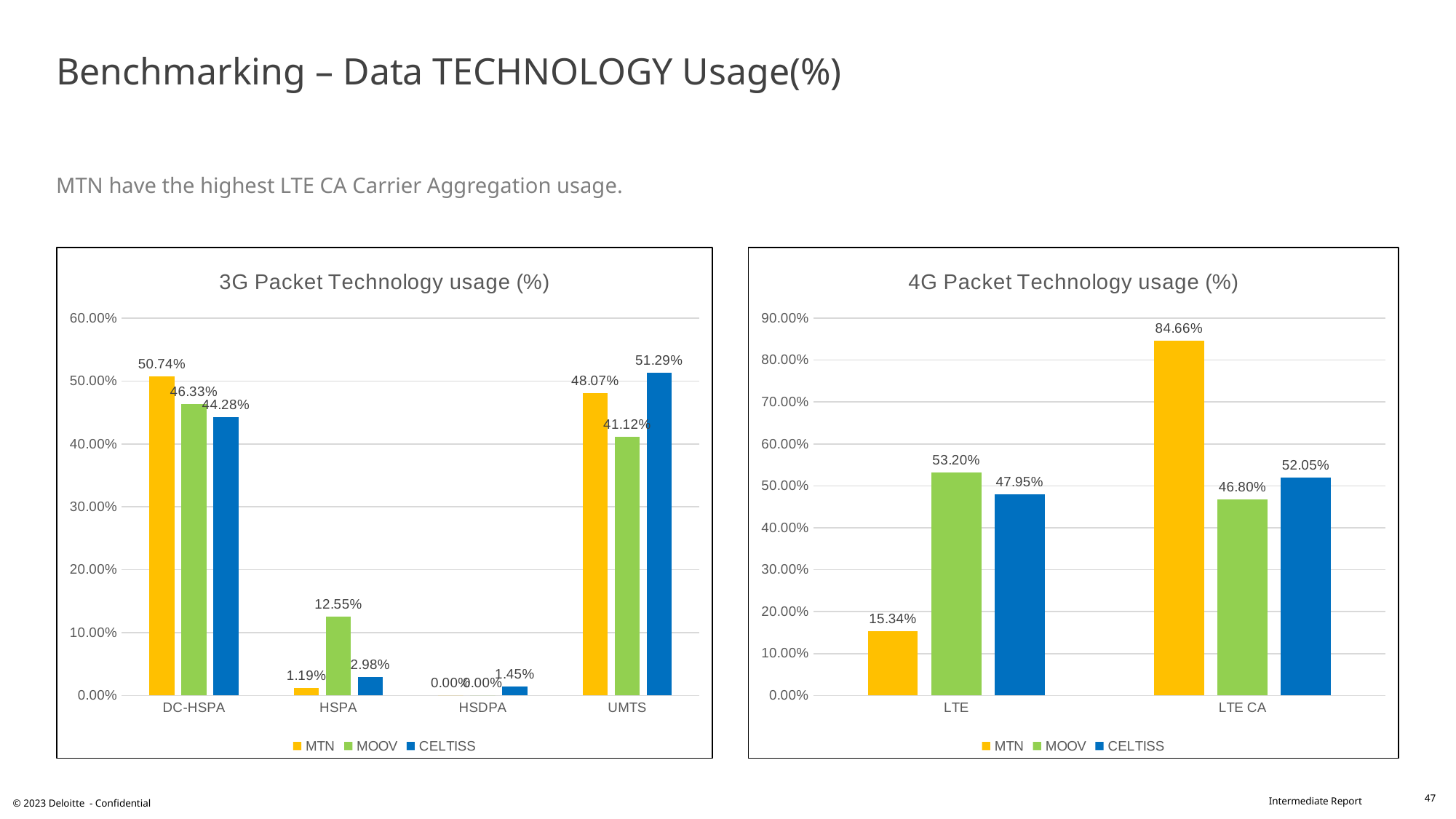
In the 3G Packet Technology usage (%) chart, what is the difference between the CELTISS and MTN values for UMTS? 3.22% In the 3G Packet Technology usage (%) chart, what is the value for MTN in DC-HSPA? 50.74% In the 4G Packet Technology usage (%) chart, which operator has the highest value for LTE? MOOV How many series does the legend of the 4G Packet Technology usage (%) chart list? 3 In the 3G Packet Technology usage (%) chart, how many technology categories are shown on the x axis? 4 In the 3G Packet Technology usage (%) chart, what is the value for MOOV in HSPA? 12.55% In the 4G Packet Technology usage (%) chart, what is the value for MTN in LTE CA? 84.66% In the 4G Packet Technology usage (%) chart, what is the difference between the MTN and MOOV values for LTE CA? 37.86% In the 4G Packet Technology usage (%) chart, what is the value for CELTISS in LTE? 47.95% In the 3G Packet Technology usage (%) chart, which operator has the highest value for UMTS? CELTISS In the 3G Packet Technology usage (%) chart, which operator has the lowest value for DC-HSPA? CELTISS In the 4G Packet Technology usage (%) chart, is the MTN value for LTE CA greater or less than 80.00%? greater